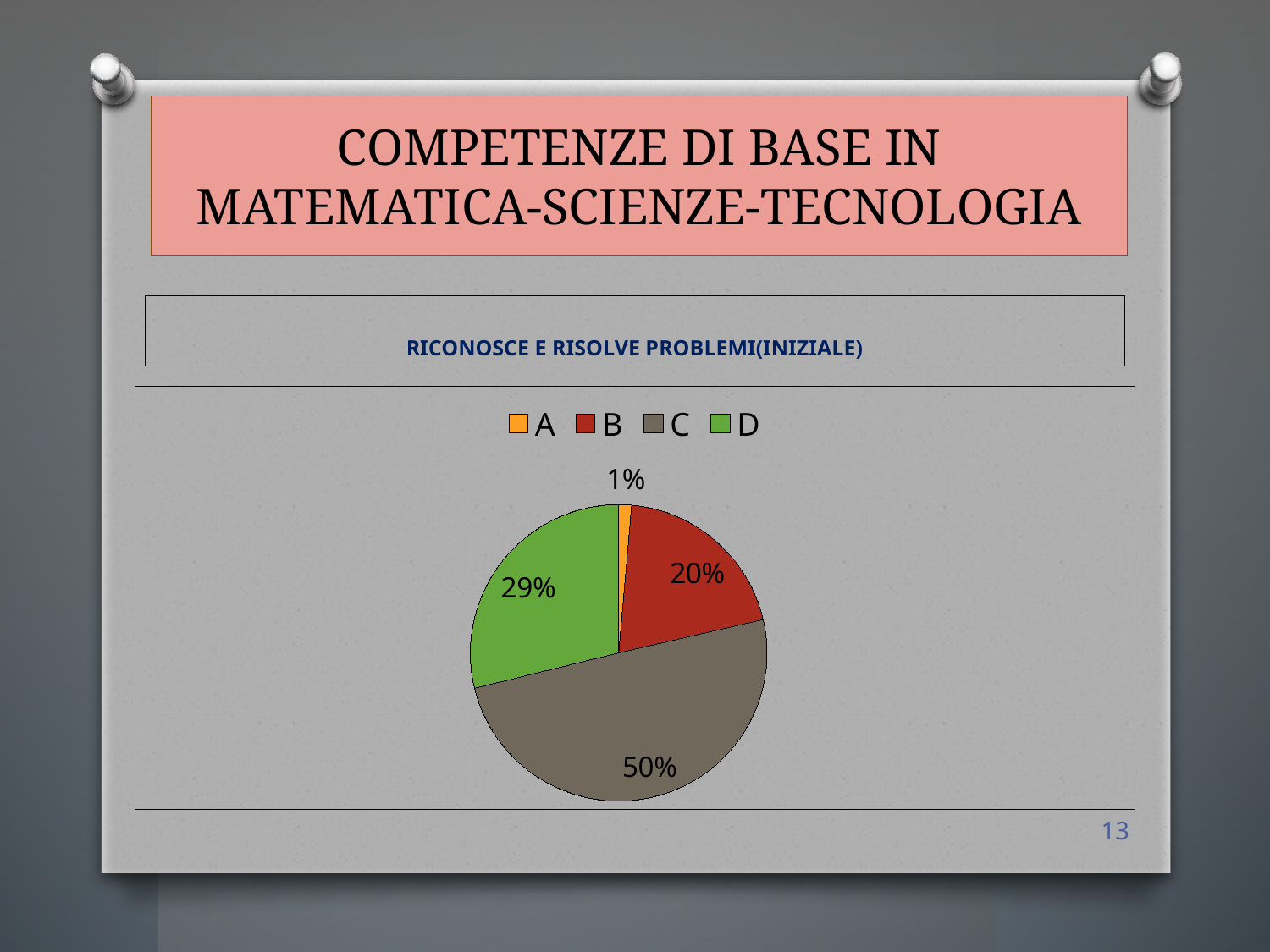
How many categories does the legend list? 4 What kind of chart is shown on the slide? pie chart What share of the pie does category A have? 1% What share of the pie does category B have? 20% Which category has the smallest slice of the pie? A What colour is the slice for category D? green What is the difference between the shares of C and D? 21% Which is larger, the share of D or the share of B? D What is the difference between the shares of B and A? 19% What share of the pie does category C have? 50% Which category has the largest slice of the pie? C